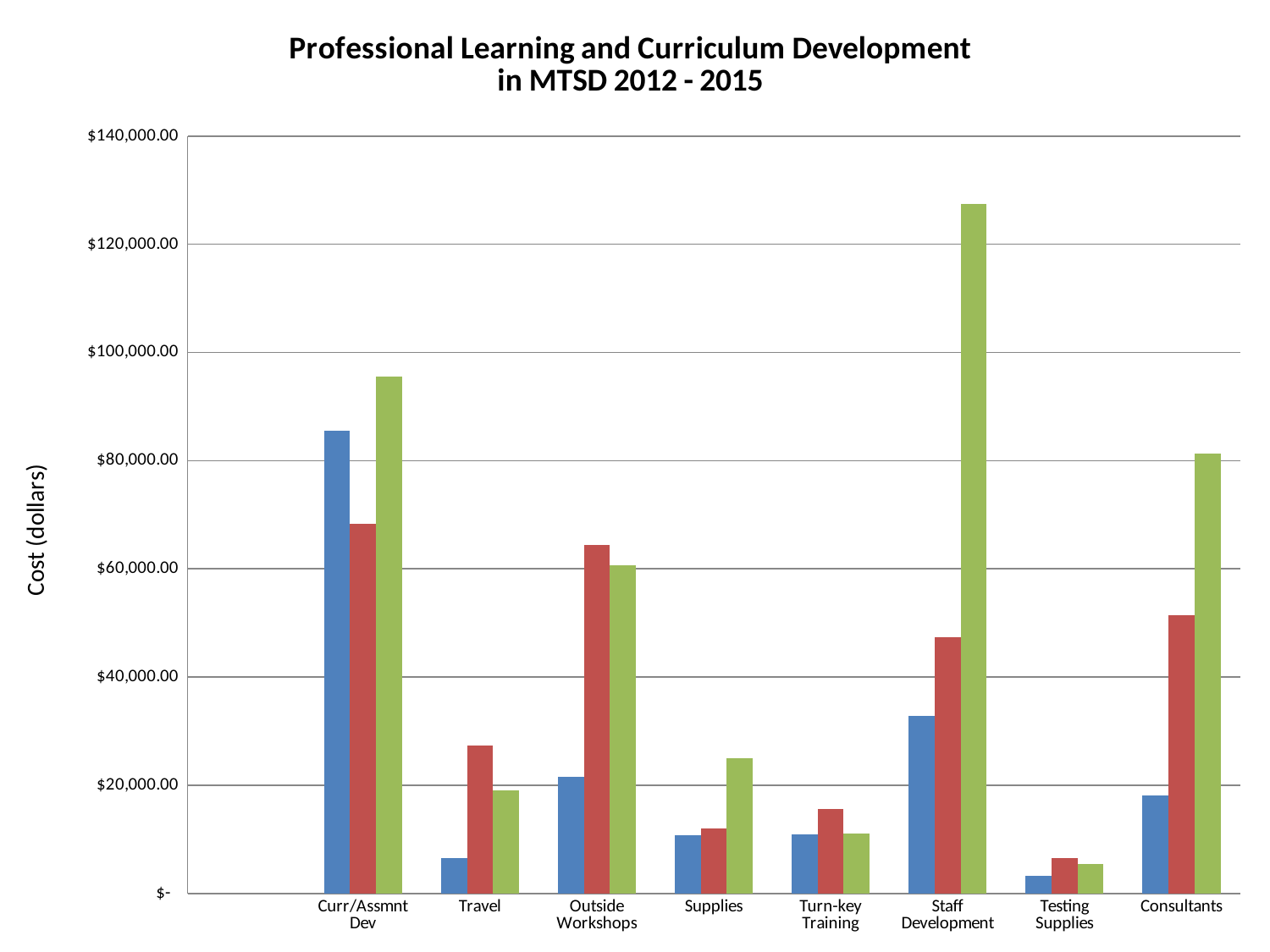
Which category contains the tallest bar in the chart? Staff Development Which category has the lowest bars overall in the chart? Testing Supplies How many bars are plotted for each category in the chart? 3 Is the value of the green bar for Staff Development greater or less than $120,000.00? greater How many categories are shown along the x axis of the chart? 8 Is the value of the blue bar for Travel greater or less than $20,000.00? less Is the value of the blue bar for Curr/Assmnt Dev greater or less than $80,000.00? greater For Curr/Assmnt Dev, which bar is larger, the blue bar or the red bar? blue What kind of chart is shown on the slide? bar chart For Consultants, which bar is larger, the red bar or the green bar? green What is the label on the vertical axis of the chart? Cost (dollars) What is the title of the chart? Professional Learning and Curriculum Development in MTSD 2012 - 2015